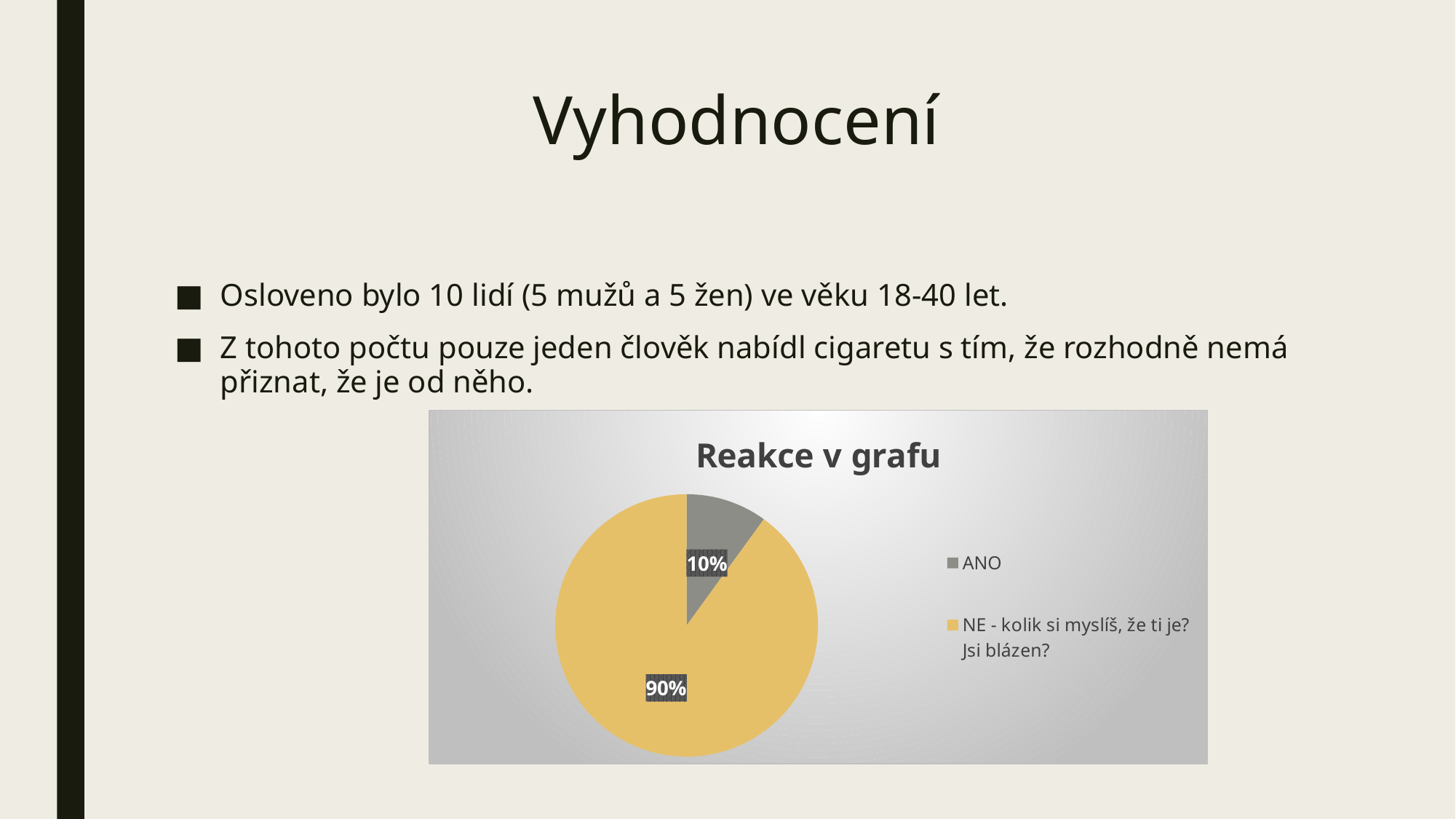
Which slice is the smallest in the pie chart? ANO What is the difference in percentage points between the NE slice and the ANO slice? 80% What is the title of the chart? Reakce v grafu What share of the pie does the ANO slice represent? 10% What kind of chart is shown on the slide? pie chart What share of the pie does the 'NE - kolik si myslíš, že ti je? Jsi blázen?' slice represent? 90% Which slice is the largest in the pie chart? NE - kolik si myslíš, že ti je? Jsi blázen? Which is larger, the ANO slice or the NE slice? NE How many entries does the legend list? 2 What colour is the ANO slice in the pie chart? grey How many slices does the pie chart have? 2